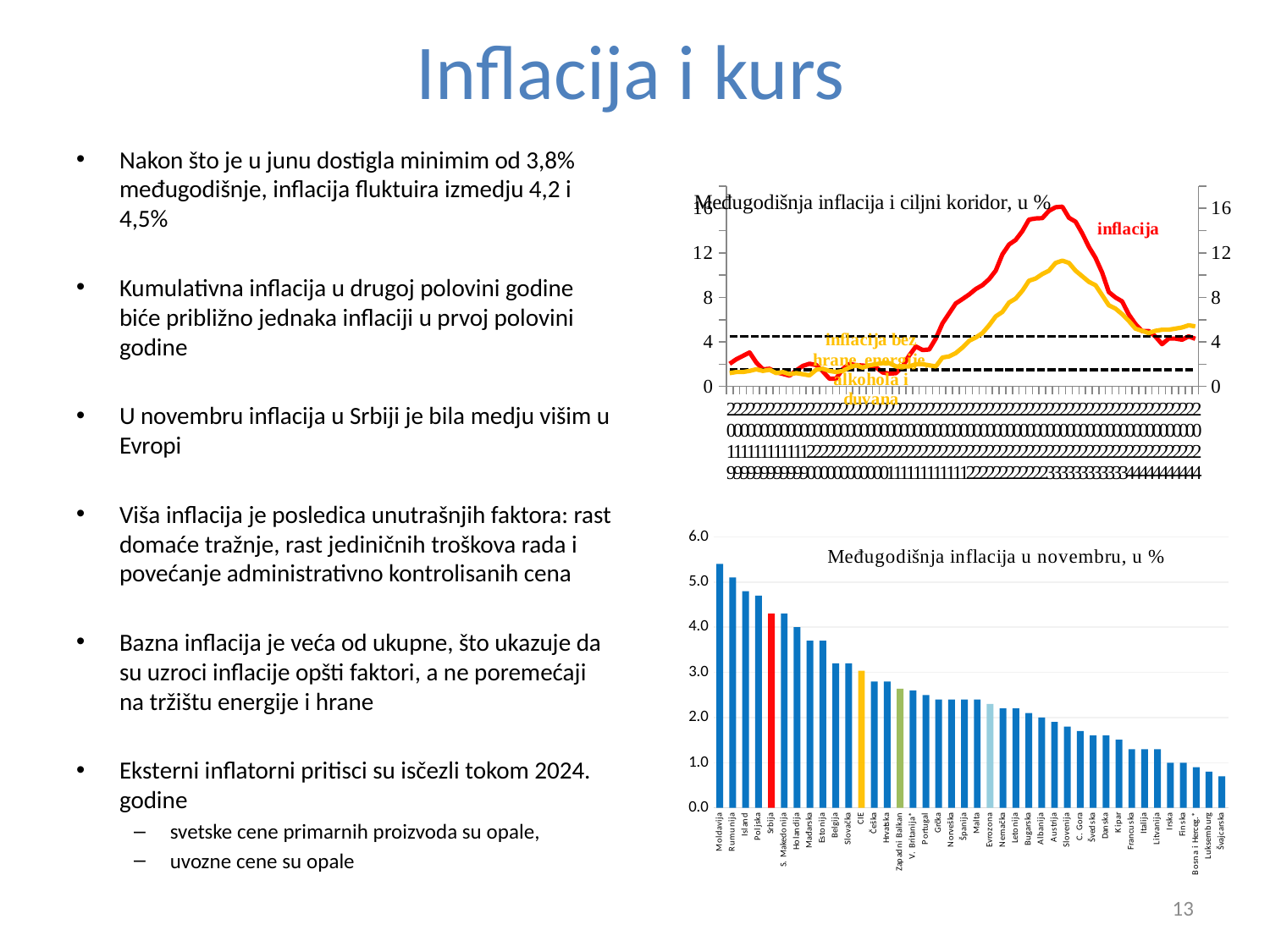
In the chart 'Međugodišnja inflacija i ciljni koridor, u %', what colour is the 'inflacija' line? red In the chart 'Međugodišnja inflacija u novembru, u %', is the value for Moldavija greater or less than 5.0? greater In the chart 'Međugodišnja inflacija u novembru, u %', which is larger, the value for Srbija or the value for Evrozona? Srbija What kind of chart is the chart titled 'Međugodišnja inflacija u novembru, u %'? bar chart In the chart 'Međugodišnja inflacija u novembru, u %', which country has the highest value? Moldavija In the chart 'Međugodišnja inflacija u novembru, u %', is the value for Švajcarska greater or less than 1.0? less In the chart 'Međugodišnja inflacija u novembru, u %', which is larger, the value for Moldavija or the value for Luksemburg? Moldavija In the chart 'Međugodišnja inflacija i ciljni koridor, u %', which series reaches the higher peak, 'inflacija' or 'inflacija bez hrane, energije, alkohola i duvana'? inflacija In the chart 'Međugodišnja inflacija u novembru, u %', which country has the lowest value? Švajcarska In the chart 'Međugodišnja inflacija u novembru, u %', is the value for Srbija greater or less than 5.0? less In the chart 'Međugodišnja inflacija i ciljni koridor, u %', how many data series (lines) are plotted, excluding the dashed corridor lines? 2 What kind of chart is the chart titled 'Međugodišnja inflacija i ciljni koridor, u %'? line chart